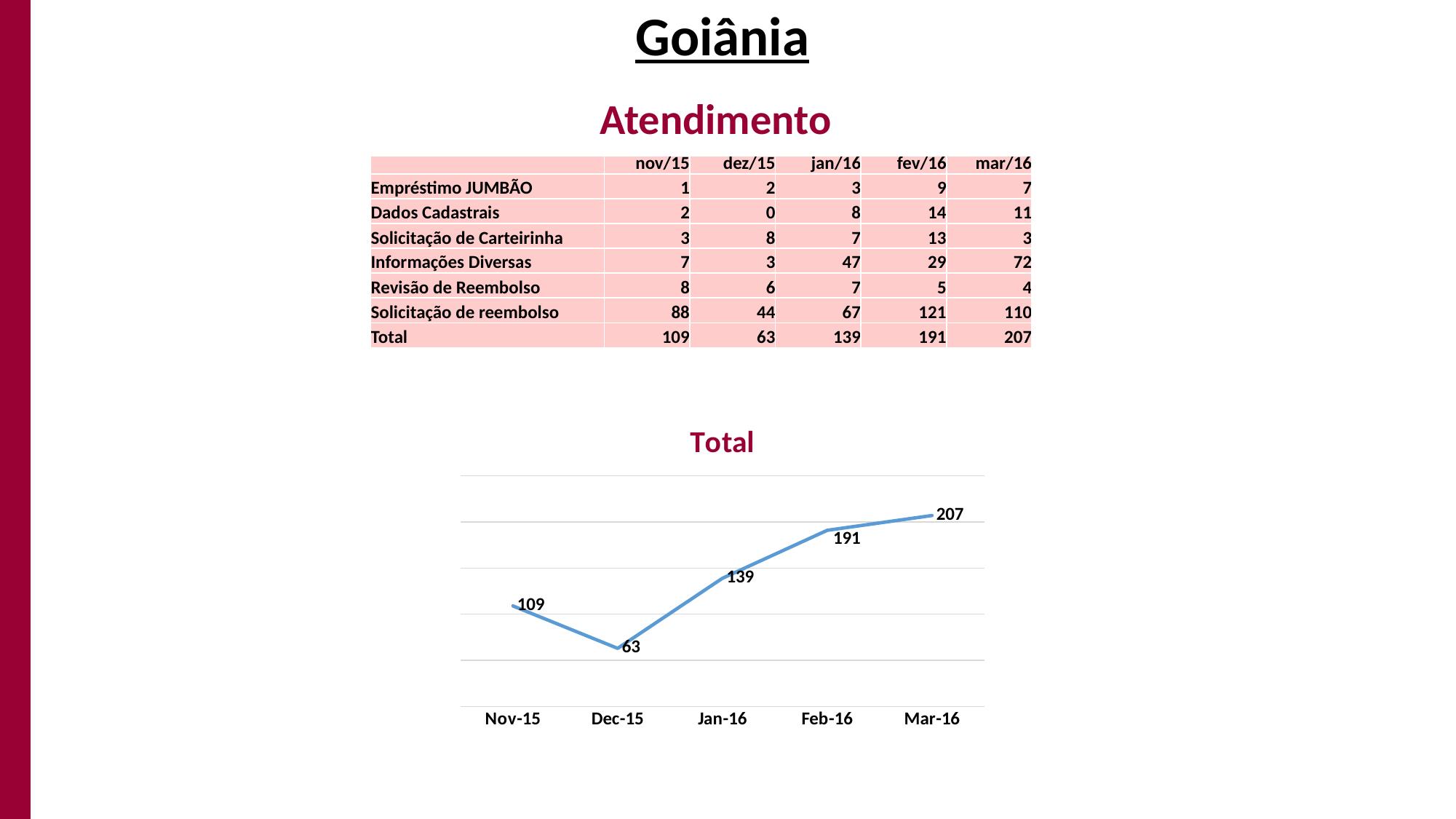
Which month has the highest value in the Total chart? Mar-16 Do the values in the Total chart rise or fall from Dec-15 to Mar-16? rise Which is larger in the Total chart, the value for Nov-15 or the value for Jan-16? Jan-16 What is the difference between the Mar-16 and Feb-16 values in the Total chart? 16 How many data points are plotted in the Total chart? 5 What kind of chart is the Total chart? line chart What is the difference between the Nov-15 and Dec-15 values in the Total chart? 46 What is the title of the chart on the slide? Total Which month has the lowest value in the Total chart? Dec-15 What is the value for Dec-15 in the Total chart? 63 What is the value for Mar-16 in the Total chart? 207 What is the value for Jan-16 in the Total chart? 139